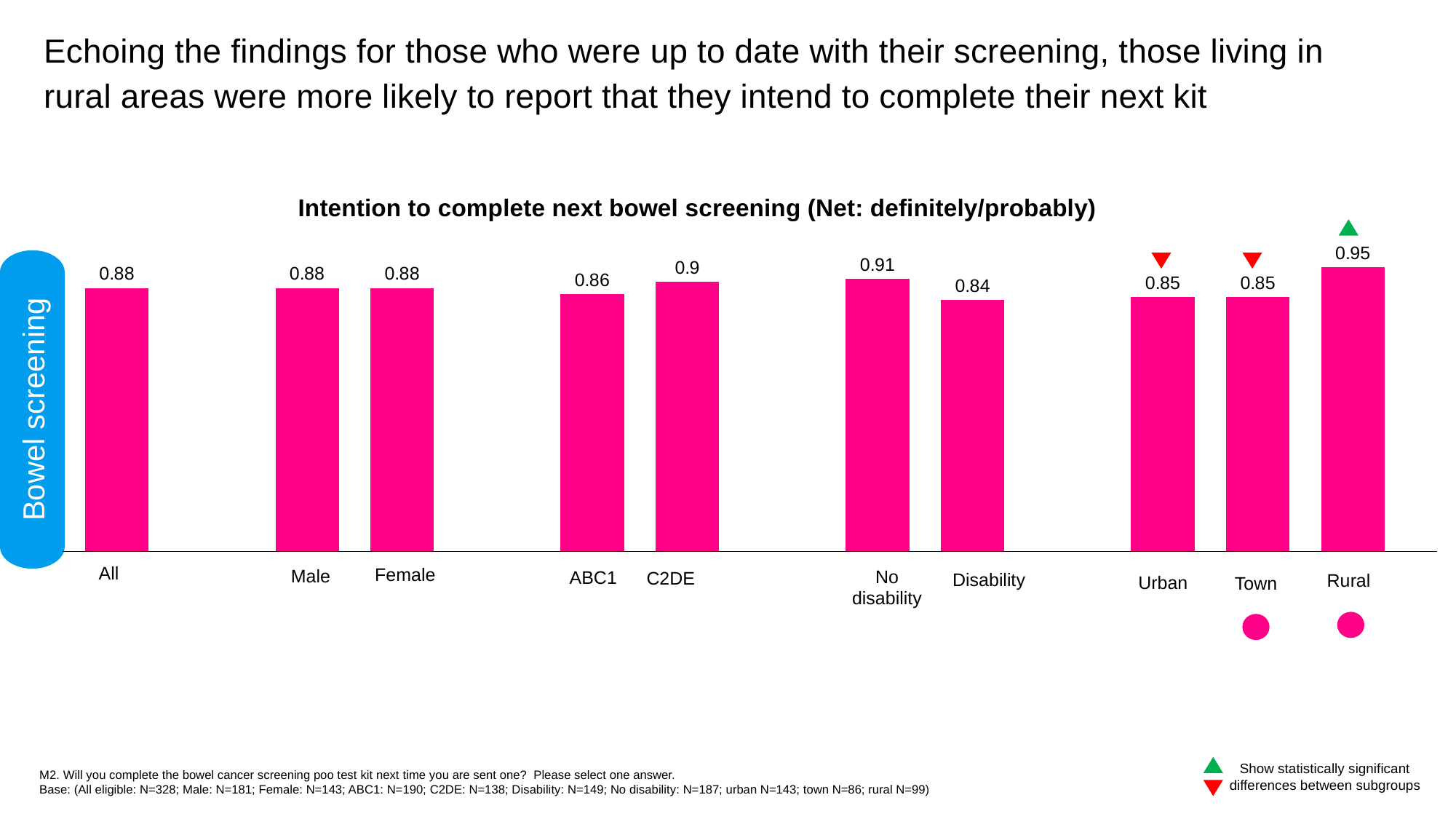
What kind of chart is shown on the slide? Bar chart How many categories are shown on the chart? 10 What is the value for Disability? 0.84 What is the difference between the values for No disability and Disability? 0.07 What is the value for C2DE? 0.9 What is the value for No disability? 0.91 Which category has the lowest value? Disability What is the difference between the values for Rural and Urban? 0.1 What is the title of the chart? Intention to complete next bowel screening (Net: definitely/probably) Which category has the highest value? Rural What is the value for Rural? 0.95 Which is larger, the value for C2DE or the value for ABC1? C2DE